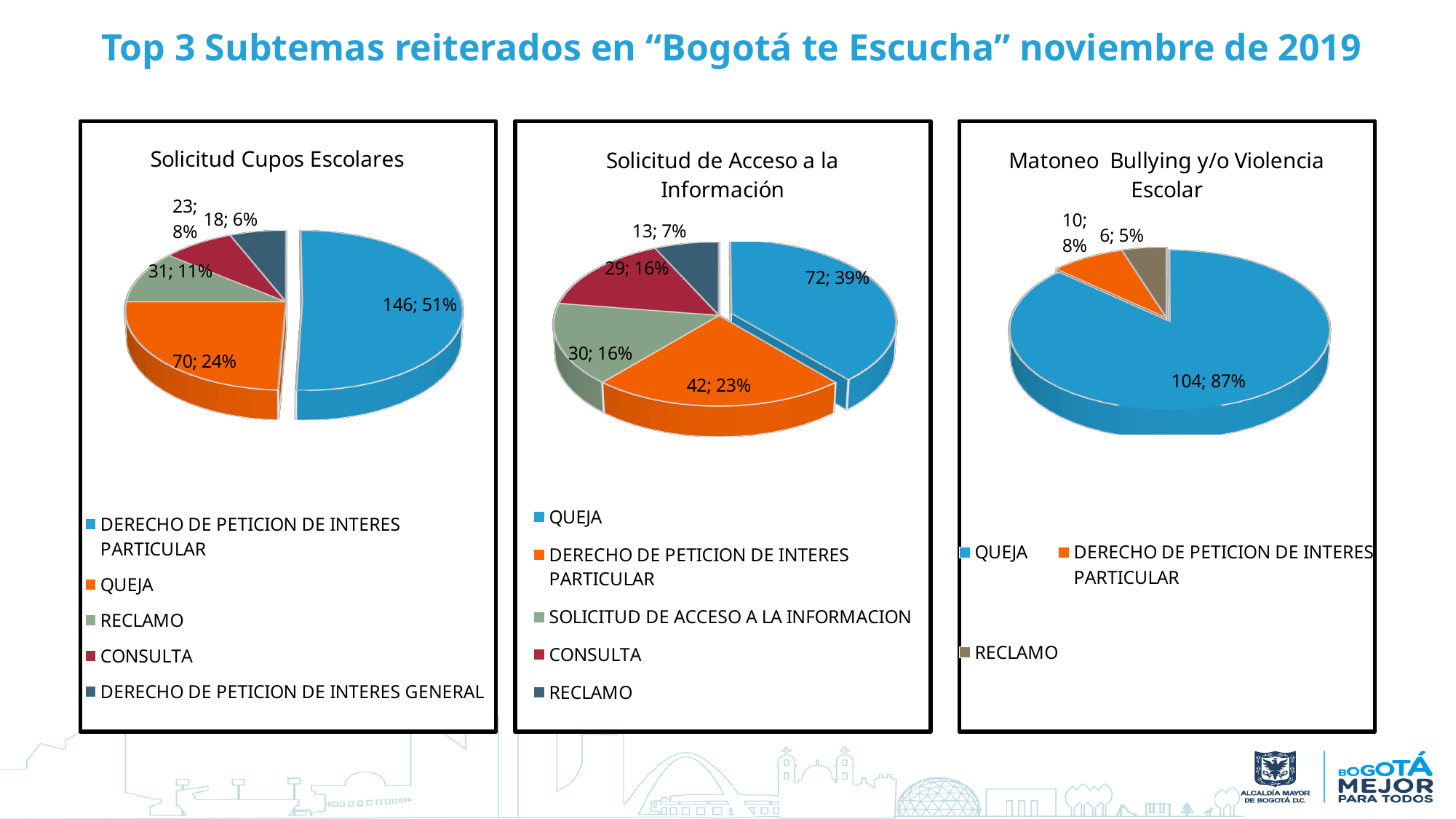
In the 'Solicitud Cupos Escolares' chart, what is the difference between the counts for DERECHO DE PETICION DE INTERES PARTICULAR and QUEJA? 76 In the 'Solicitud Cupos Escolares' chart, which category has the largest slice? DERECHO DE PETICION DE INTERES PARTICULAR In the 'Matoneo Bullying y/o Violencia Escolar' chart, what is the count for RECLAMO? 6 In the 'Solicitud Cupos Escolares' chart, which category has the smallest slice? DERECHO DE PETICION DE INTERES GENERAL How many categories does the 'Solicitud de Acceso a la Información' chart show? 5 In the 'Solicitud de Acceso a la Información' chart, which is larger: QUEJA or DERECHO DE PETICION DE INTERES PARTICULAR? QUEJA In the 'Solicitud de Acceso a la Información' chart, what value is shown for QUEJA? 72; 39% What type of chart is the 'Matoneo Bullying y/o Violencia Escolar' chart? Pie chart In the 'Solicitud Cupos Escolares' chart, what share of the pie does RECLAMO represent? 11% In the 'Solicitud de Acceso a la Información' chart, which category has the smallest slice? RECLAMO In the 'Solicitud Cupos Escolares' chart, what value is shown for QUEJA? 70; 24% In the 'Matoneo Bullying y/o Violencia Escolar' chart, what share of the pie does QUEJA represent? 87%